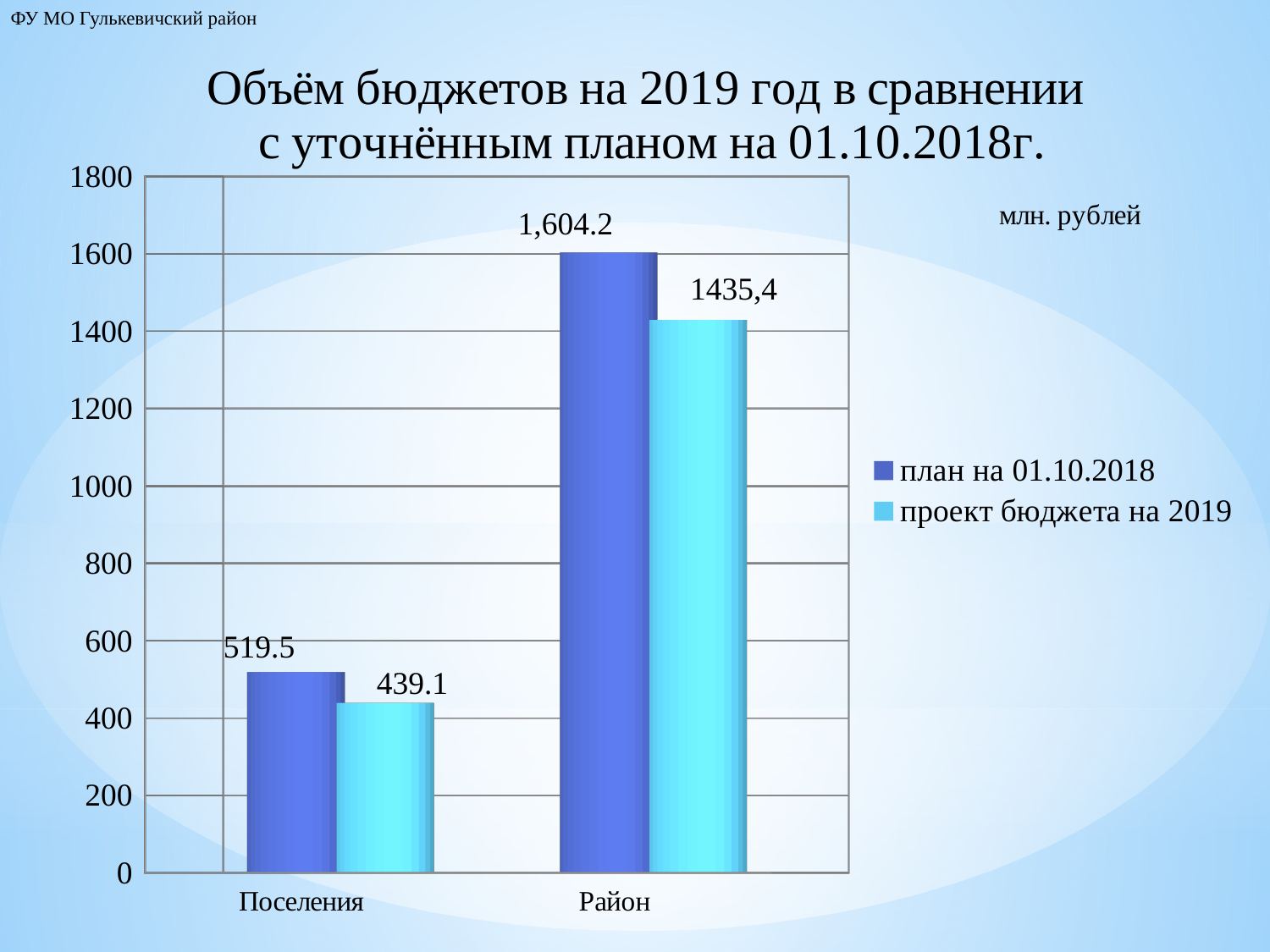
What is the value for Район in the series проект бюджета на 2019? 1435,4 How many categories are shown on the x axis? 2 What is the difference between the план на 01.10.2018 and проект бюджета на 2019 values for Поселения? 80.4 Which category has the highest value in the series план на 01.10.2018? Район Which category has the lowest value in the series проект бюджета на 2019? Поселения What is the value for Район in the series план на 01.10.2018? 1,604.2 What is the difference between the план на 01.10.2018 and проект бюджета на 2019 values for Район? 168.8 For Район, which is larger: план на 01.10.2018 or проект бюджета на 2019? план на 01.10.2018 What kind of chart is shown on the slide? bar chart What is the value for Поселения in the series план на 01.10.2018? 519.5 How many series does the legend list? 2 What is the value for Поселения in the series проект бюджета на 2019? 439.1